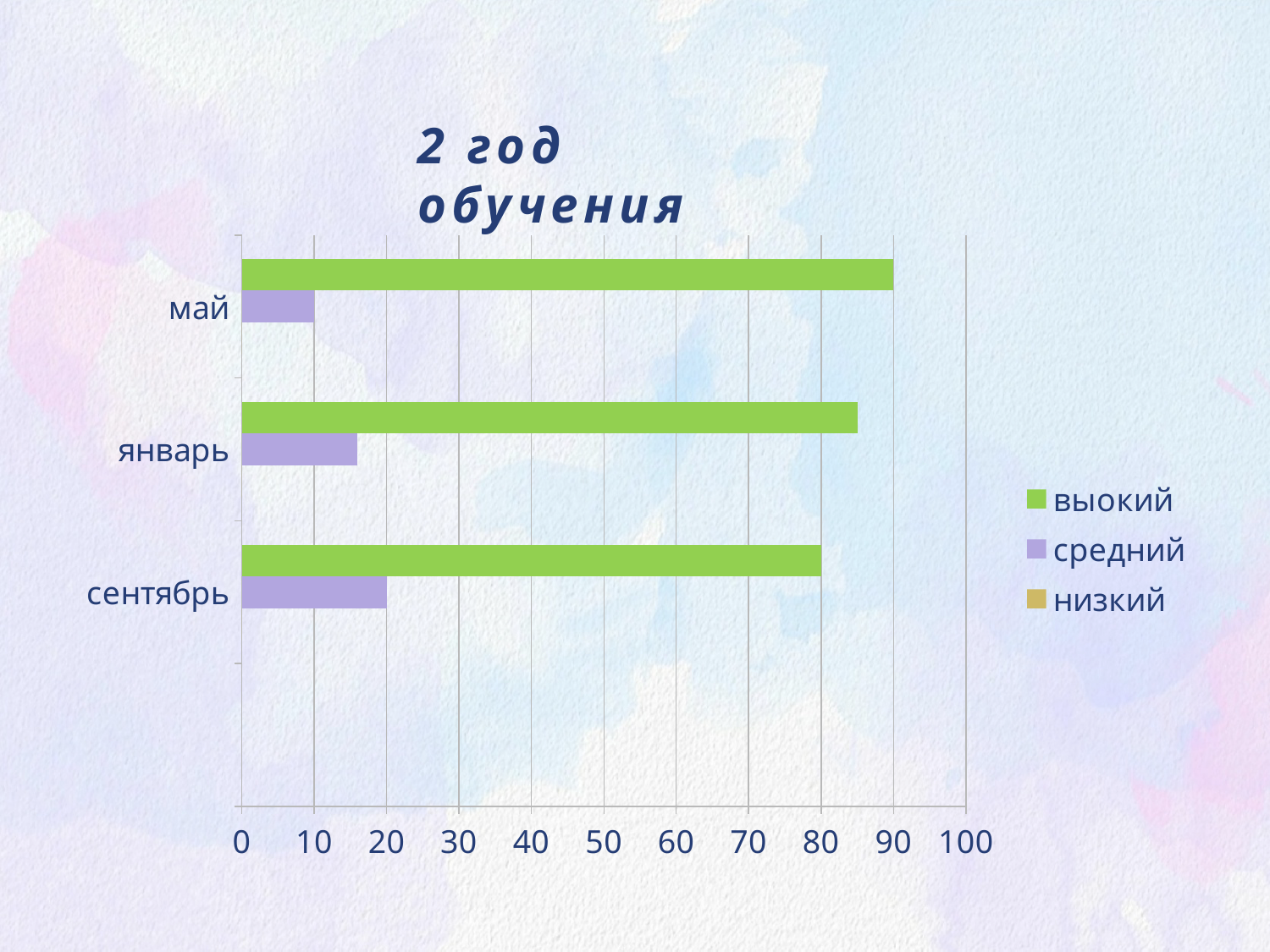
Is the выокий value for январь greater or less than 80? greater How many series does the legend list? 3 Which category has the highest выокий value? май What is the value of the выокий series for сентябрь? 80 How many categories are shown on the vertical axis? 3 What is the title of the chart? 2 год обучения What is the value of the выокий series for май? 90 Is the средний value for январь greater or less than 20? less What is the value of the средний series for май? 10 What is the difference between the выокий values for май and сентябрь? 10 What kind of chart is shown on the slide? bar chart What is the value of the средний series for сентябрь? 20